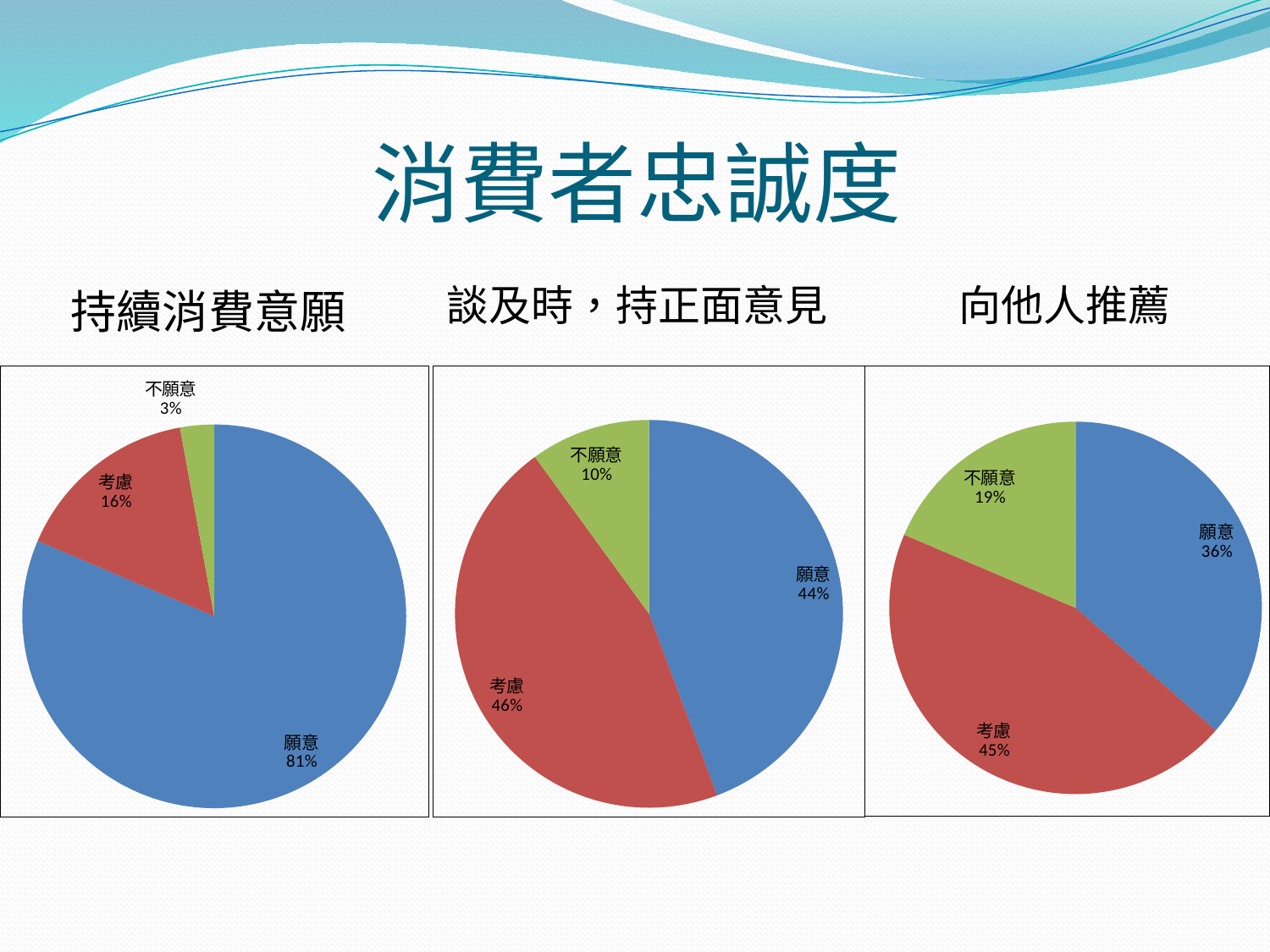
How many slices does the right pie chart (向他人推薦) have? 3 In the right pie chart (向他人推薦), what is the share for 不願意? 19% In the left pie chart (持續消費意願), what is the share for 不願意? 3% In the middle pie chart (談及時，持正面意見), which category has the smallest share? 不願意 What type of chart is used for 持續消費意願? Pie chart In the right pie chart (向他人推薦), what is the difference between the shares for 考慮 and 不願意? 26% In the left pie chart (持續消費意願), what is the share for 願意? 81% In the left pie chart (持續消費意願), which category has the largest share? 願意 In the middle pie chart (談及時，持正面意見), which is larger, the share for 願意 or the share for 不願意? 願意 In the right pie chart (向他人推薦), which category has the smallest share? 不願意 In the left pie chart (持續消費意願), what is the difference between the shares for 願意 and 考慮? 65% In the middle pie chart (談及時，持正面意見), what is the share for 考慮? 46%